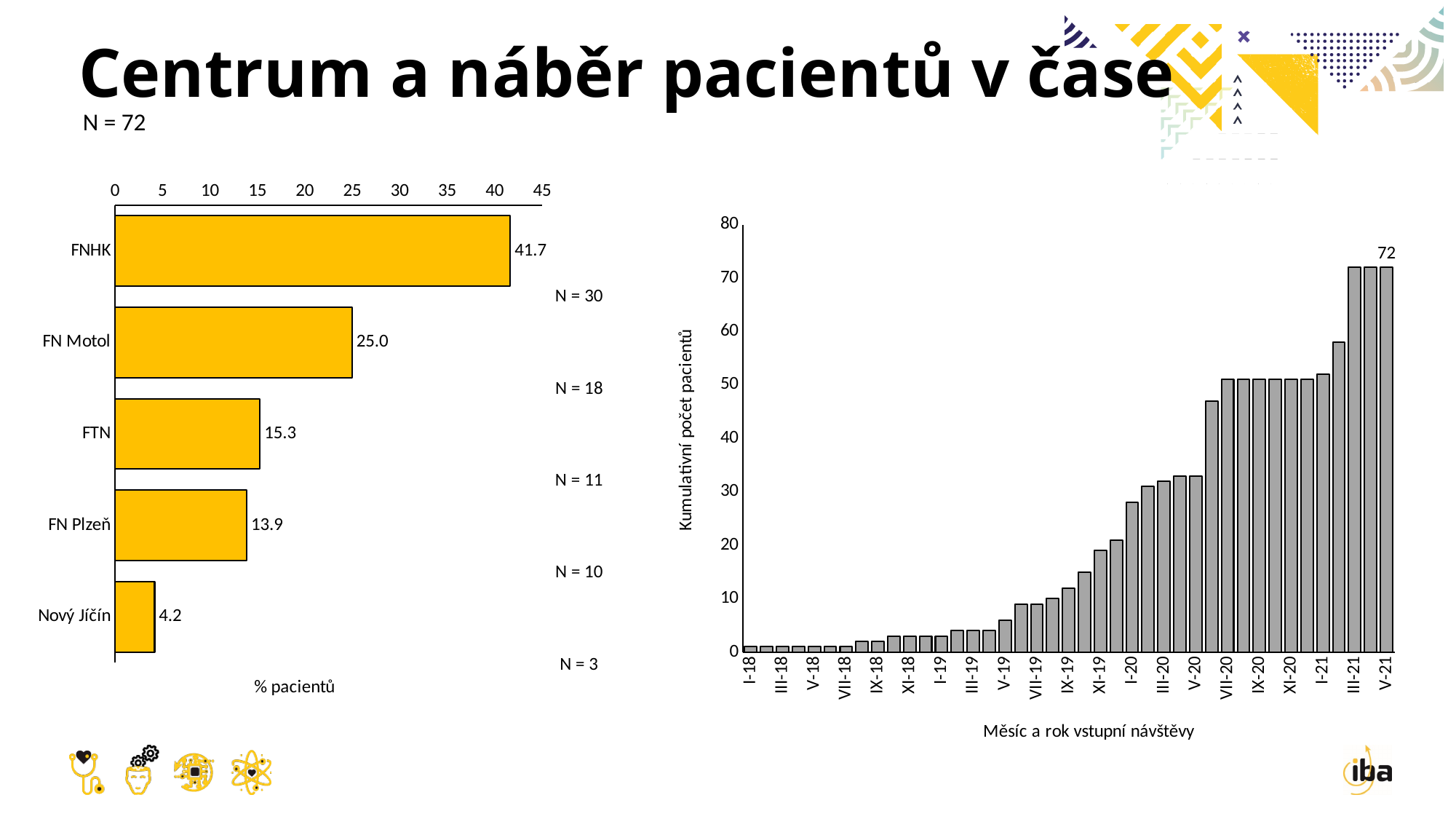
In the left chart (% pacientů), what N is shown next to the FN Motol bar? N = 18 In the right chart (Kumulativní počet pacientů), do the values rise or fall along the x axis? rise In the right chart (Kumulativní počet pacientů), is the value for I-20 greater or less than 30? less In the left chart (% pacientů), what is the difference between the values for FN Motol and FTN? 9.7 In the left chart (% pacientů), what is the value for FNHK? 41.7 In the right chart (Kumulativní počet pacientů), what is the cumulative number of patients at V-21? 72 In the left chart (% pacientů), which centre has the lowest percentage of patients? Nový Jíčín What kind of chart is the right chart (Kumulativní počet pacientů)? bar chart In the left chart (% pacientů), which centre has the highest percentage of patients? FNHK In the left chart (% pacientů), what is the value for FN Plzeň? 13.9 In the left chart (% pacientů), which is larger, the value for FTN or the value for FN Plzeň? FTN In the left chart (% pacientů), how many centres are shown? 5